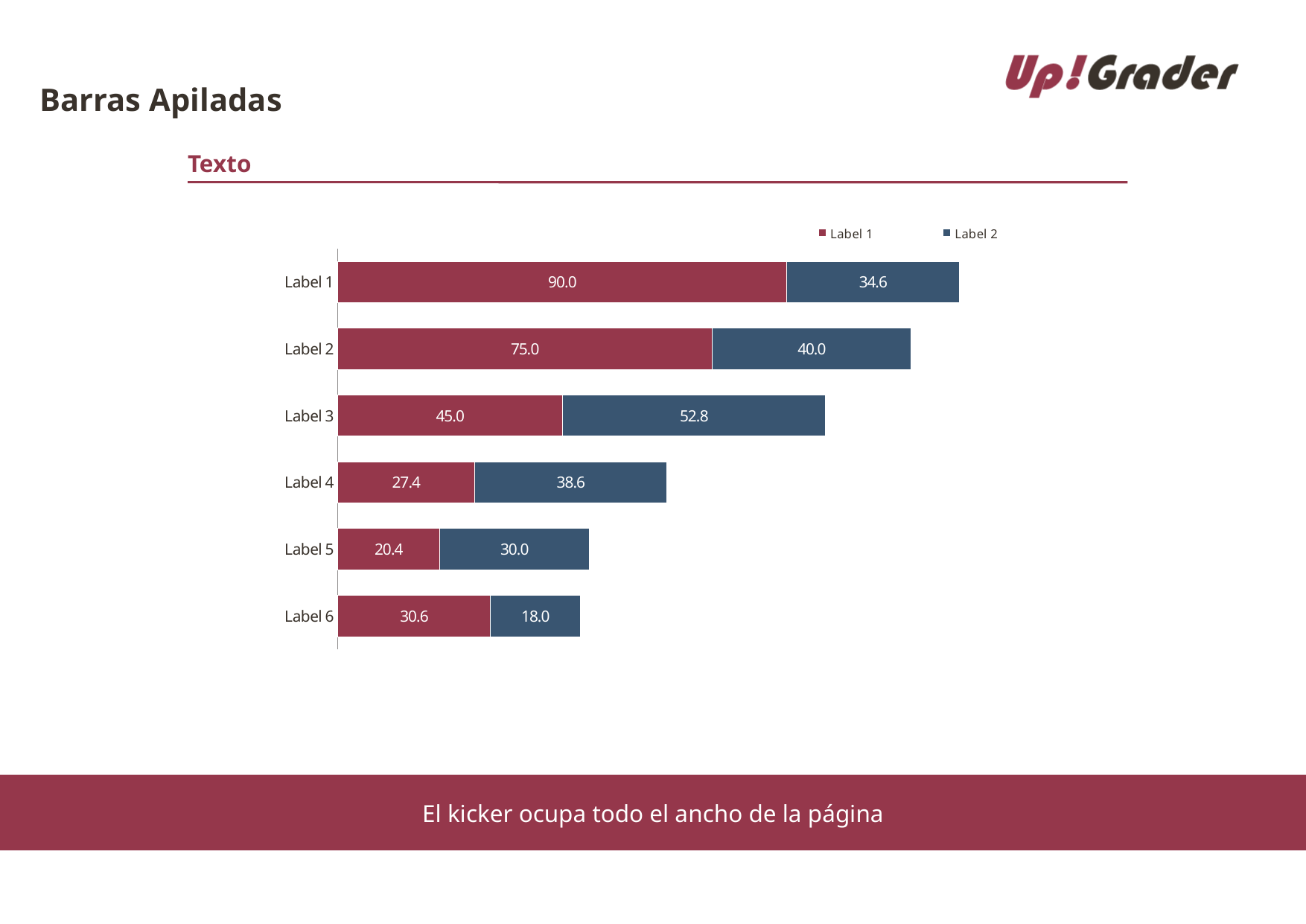
What kind of chart is shown on the slide? Stacked bar chart What is the total of the stacked bar for the category Label 5? 50.4 Which category has the lowest value in the Label 2 series? Label 6 How many categories are shown on the chart? 6 What is the total of the stacked bar for the category Label 2? 115.0 How many series does the legend list? 2 What is the value of the Label 2 series for the category Label 4? 38.6 What is the value of the Label 2 series for the category Label 6? 18.0 What is the difference between the Label 1 series values for the categories Label 1 and Label 2? 15.0 Which category has the highest value in the Label 1 series? Label 1 For the category Label 3, which series has the larger value, Label 1 or Label 2? Label 2 What is the value of the Label 1 series for the category Label 3? 45.0